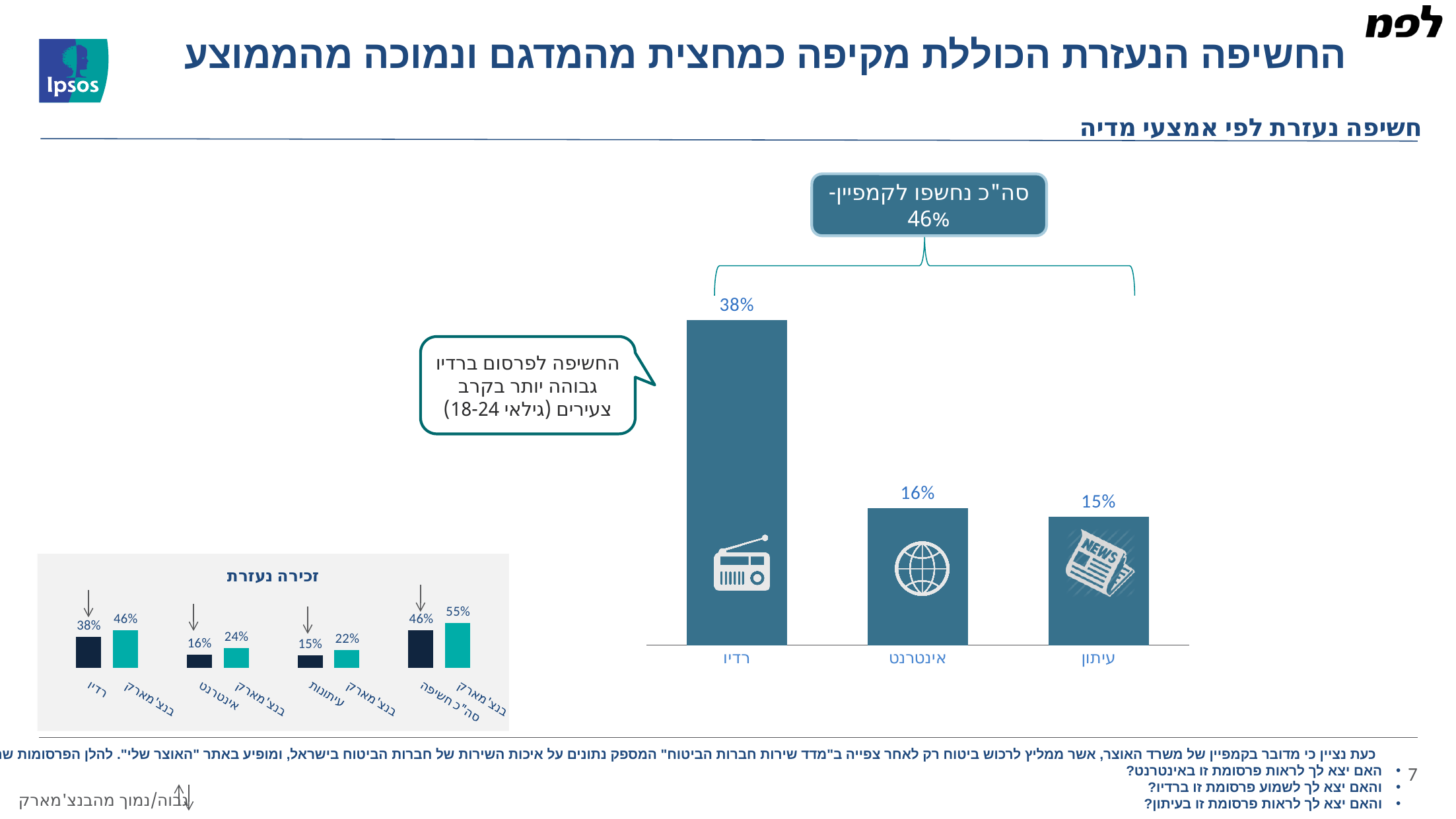
In the main chart 'חשיפה נעזרת לפי אמצעי מדיה', what is the difference between the values for רדיו and אינטרנט? 22% In the main chart 'חשיפה נעזרת לפי אמצעי מדיה', what is the value for אינטרנט? 16% What kind of chart is the main chart 'חשיפה נעזרת לפי אמצעי מדיה'? bar chart In the main chart 'חשיפה נעזרת לפי אמצעי מדיה', what is the value for רדיו? 38% In the inset chart 'זכירה נעזרת' at the bottom left, what is the בנצ'מארק value shown next to רדיו? 46% In the main chart 'חשיפה נעזרת לפי אמצעי מדיה', what total exposure to the campaign is shown in the callout above the bars? 46% In the inset chart 'זכירה נעזרת' at the bottom left, what is the value for סה"כ חשיפה? 46% In the main chart 'חשיפה נעזרת לפי אמצעי מדיה', how many categories are plotted? 3 In the inset chart 'זכירה נעזרת' at the bottom left, what is the בנצ'מארק value shown next to עיתונות? 22% In the inset chart 'זכירה נעזרת' at the bottom left, which is larger: the value for אינטרנט or its בנצ'מארק? בנצ'מארק In the main chart 'חשיפה נעזרת לפי אמצעי מדיה', which category has the highest value? רדיו In the main chart 'חשיפה נעזרת לפי אמצעי מדיה', what is the value for עיתון? 15%